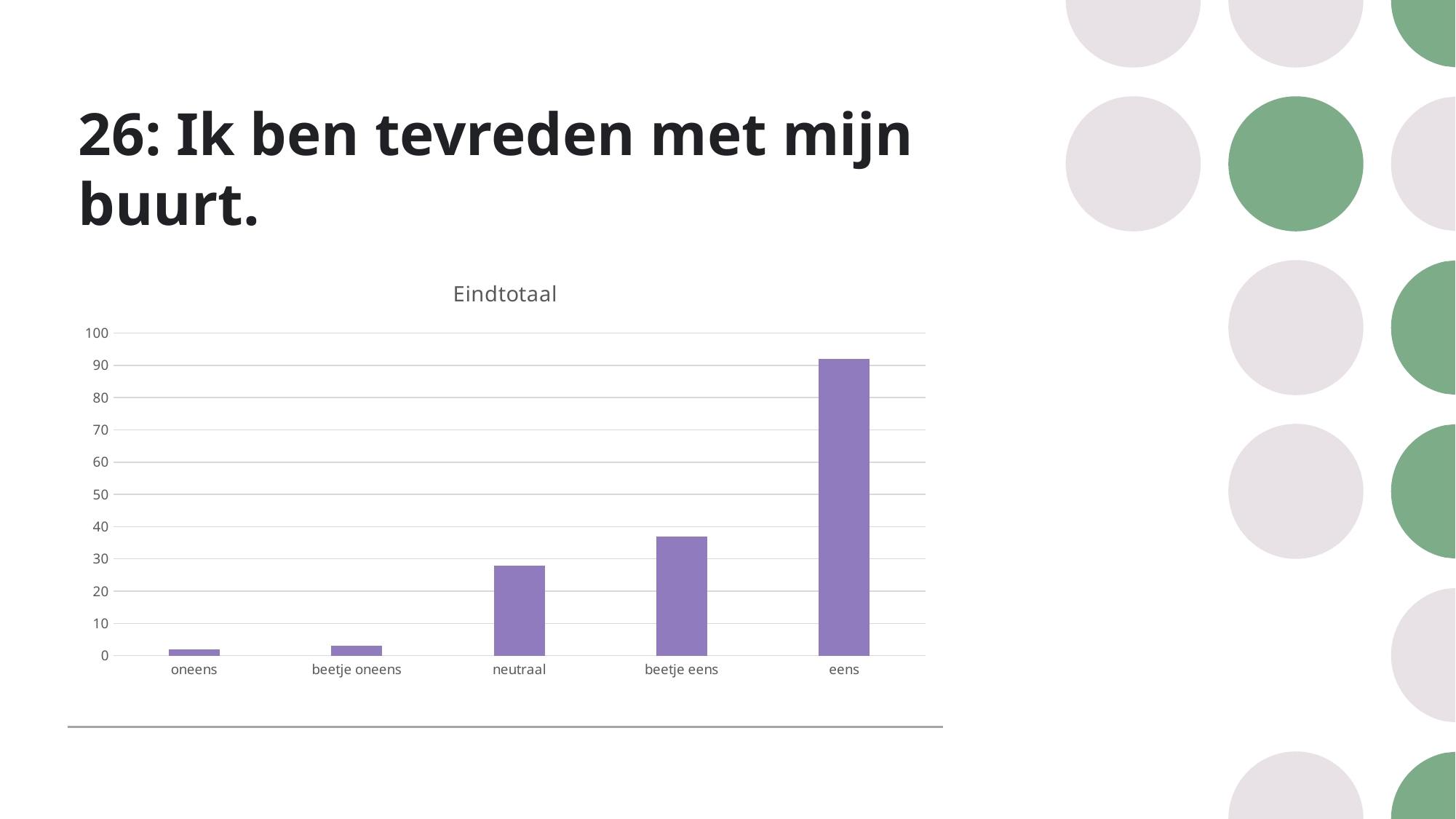
Which category has the highest value? eens How many categories are shown on the x axis of the chart? 5 Do the values rise or fall from left to right along the x axis? rise Is the value for beetje oneens greater or less than 10? less Is the value for beetje eens greater or less than 40? less Is the value for neutraal greater or less than 20? greater What is the title of the chart? Eindtotaal Which is larger, the value for neutraal or the value for beetje eens? beetje eens Which is larger, the value for eens or the value for beetje eens? eens What kind of chart is shown on the slide? bar chart